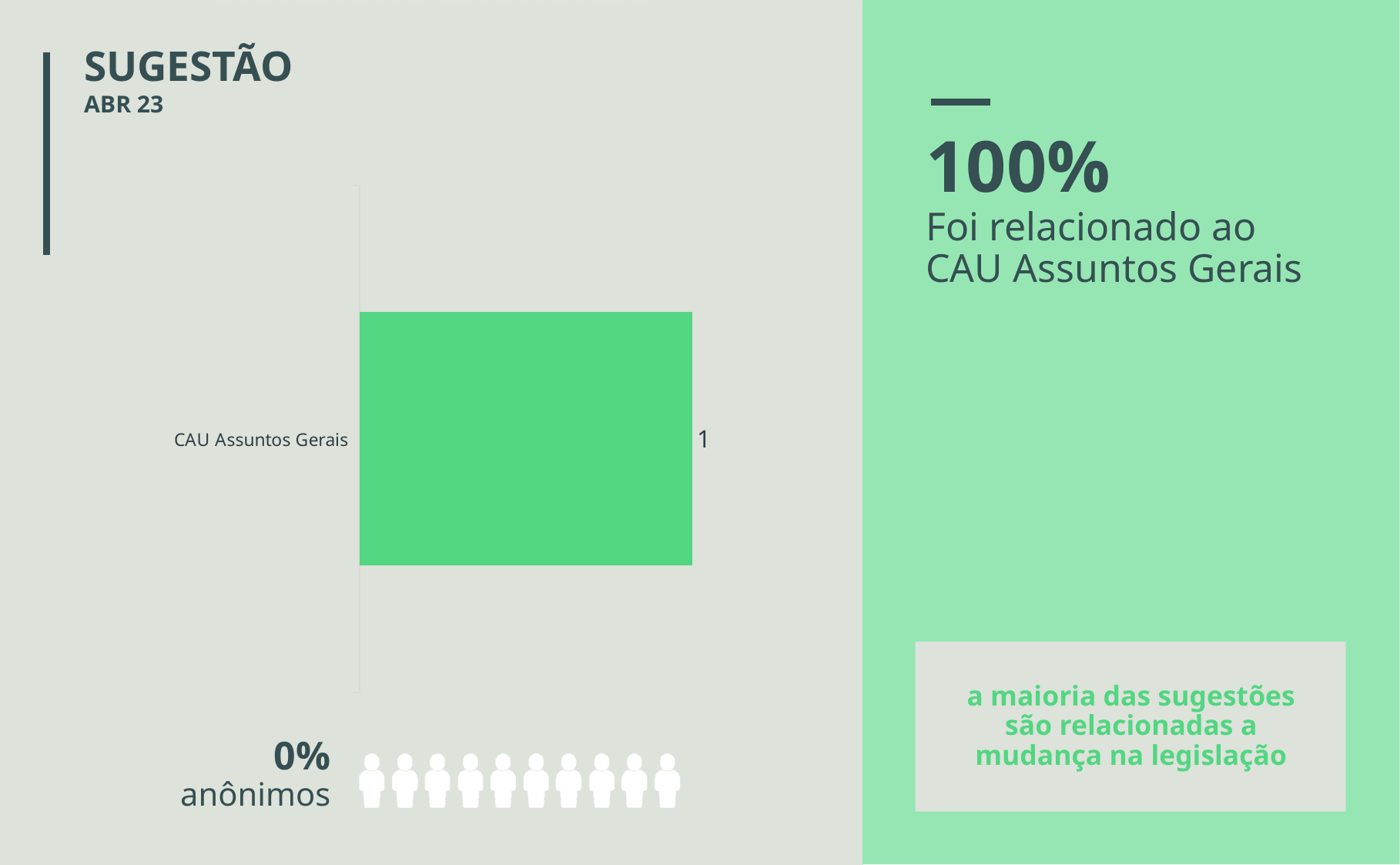
Which category has the highest value in the bar chart? CAU Assuntos Gerais What colour is the bar in the chart? green How many categories does the bar chart show? 1 What is the value for CAU Assuntos Gerais in the bar chart? 1 What is the label of the only category in the bar chart? CAU Assuntos Gerais Is the bar in the chart horizontal or vertical? horizontal What kind of chart is shown on the slide? bar chart